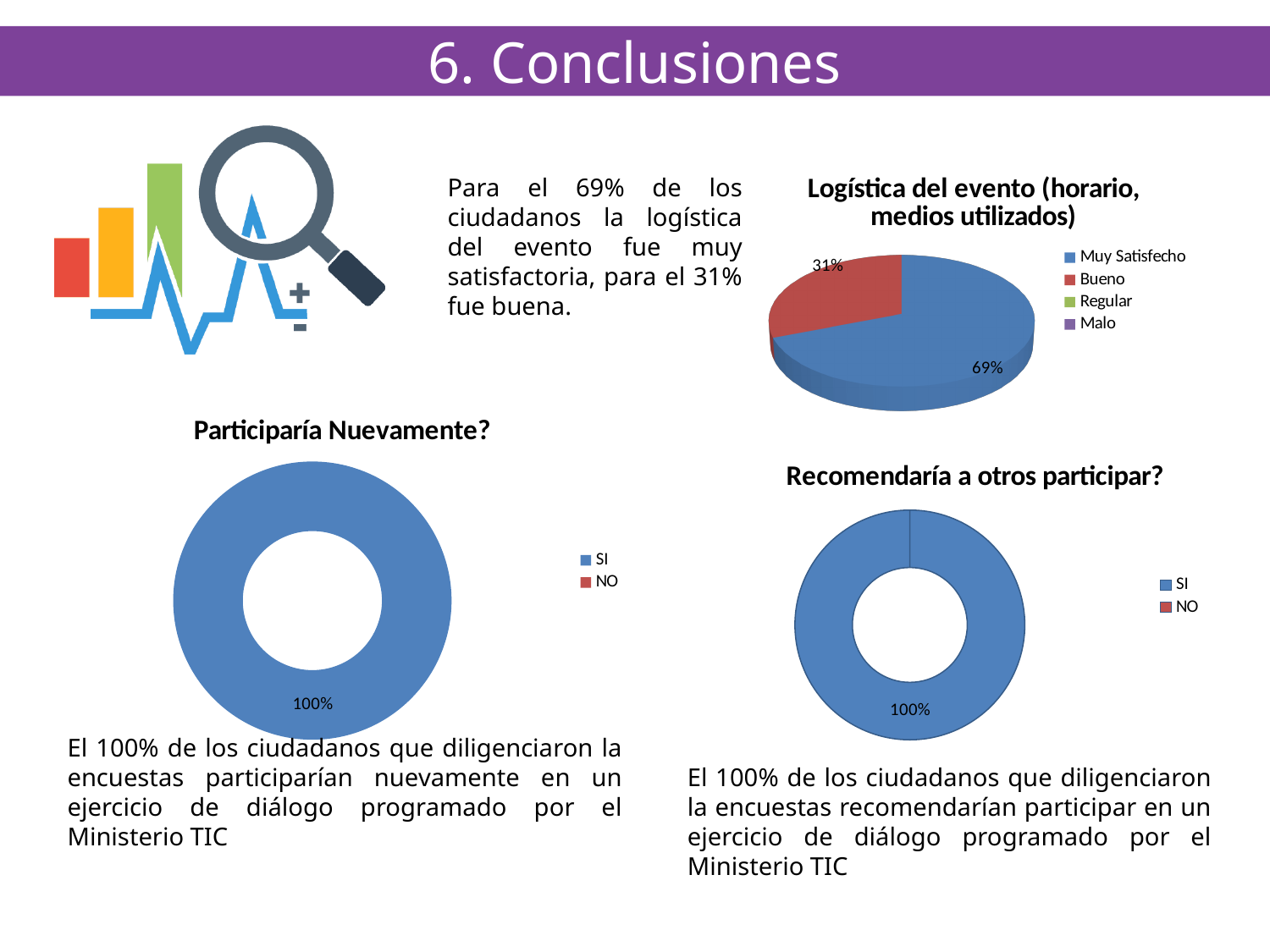
What kind of chart is 'Participaría Nuevamente?'? Doughnut chart In the 'Recomendaría a otros participar?' chart, what percentage is shown for 'SI'? 100% In the 'Logística del evento (horario, medios utilizados)' chart, which is larger, 'Muy Satisfecho' or 'Bueno'? Muy Satisfecho In the 'Logística del evento (horario, medios utilizados)' chart, what is the difference in percentage points between 'Muy Satisfecho' and 'Bueno'? 38 How many entries does the legend of the 'Logística del evento (horario, medios utilizados)' chart list? 4 How many entries does the legend of the 'Recomendaría a otros participar?' chart list? 2 In the 'Logística del evento (horario, medios utilizados)' chart, what share of the pie is 'Muy Satisfecho'? 69% In the 'Logística del evento (horario, medios utilizados)' chart, what colour is the 'Bueno' slice? Red In the 'Logística del evento (horario, medios utilizados)' chart, what share of the pie is 'Bueno'? 31% In the 'Logística del evento (horario, medios utilizados)' chart, which category has the largest slice? Muy Satisfecho In the 'Participaría Nuevamente?' chart, what percentage is shown for 'SI'? 100% What kind of chart is 'Logística del evento (horario, medios utilizados)'? Pie chart